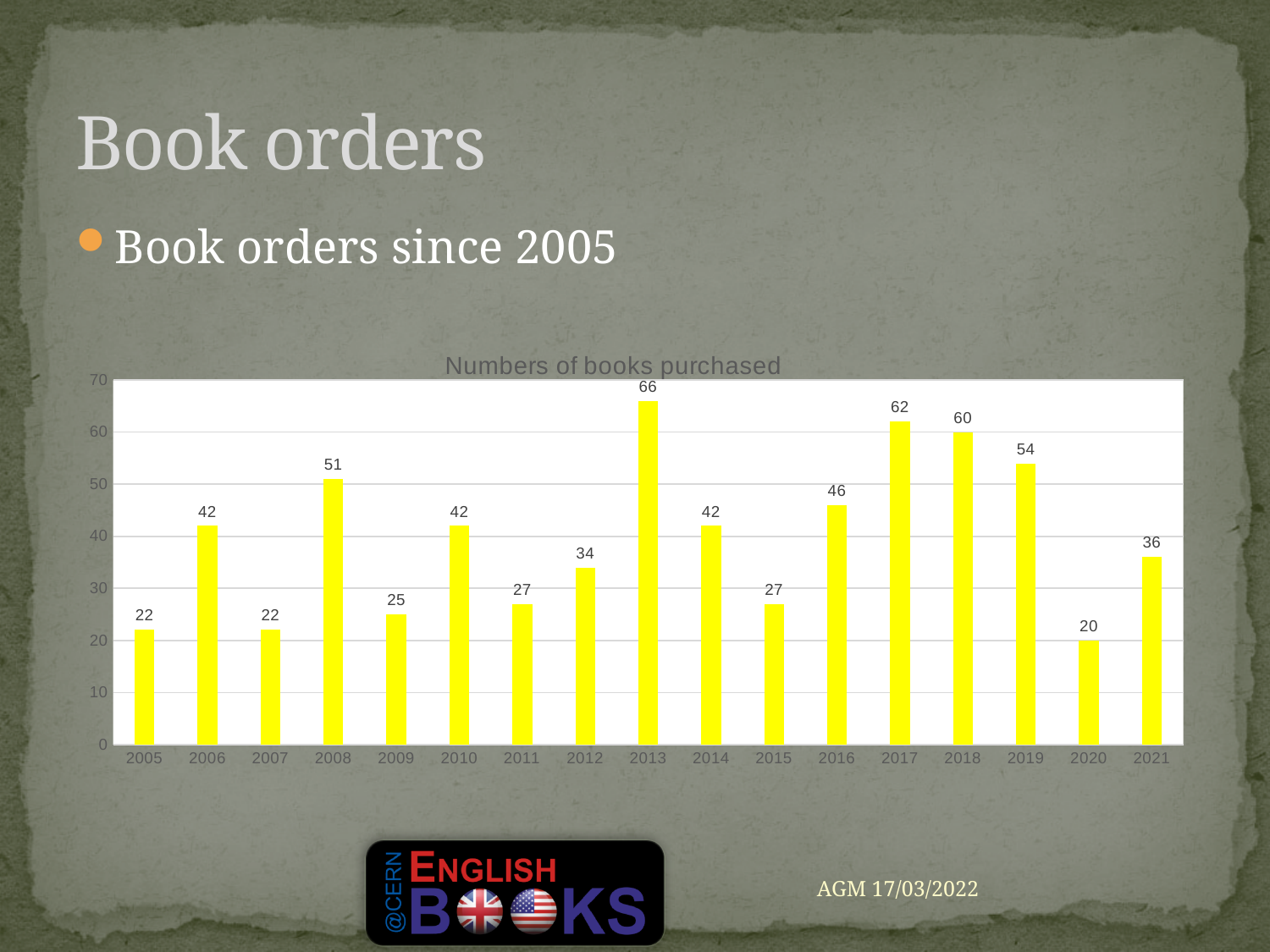
What is the title of the chart? Numbers of books purchased What is the difference between the values for 2013 and 2020? 46 Which year has the highest number of books purchased? 2013 How many years are shown on the x axis? 17 What is the value for 2008? 51 What is the value for 2013? 66 Which year has the lowest number of books purchased? 2020 What is the value for 2020? 20 Which is larger, the value for 2016 or the value for 2019? 2019 What kind of chart is shown on the slide? bar chart Is the value for 2021 greater or less than 30? greater What is the difference between the values for 2017 and 2018? 2